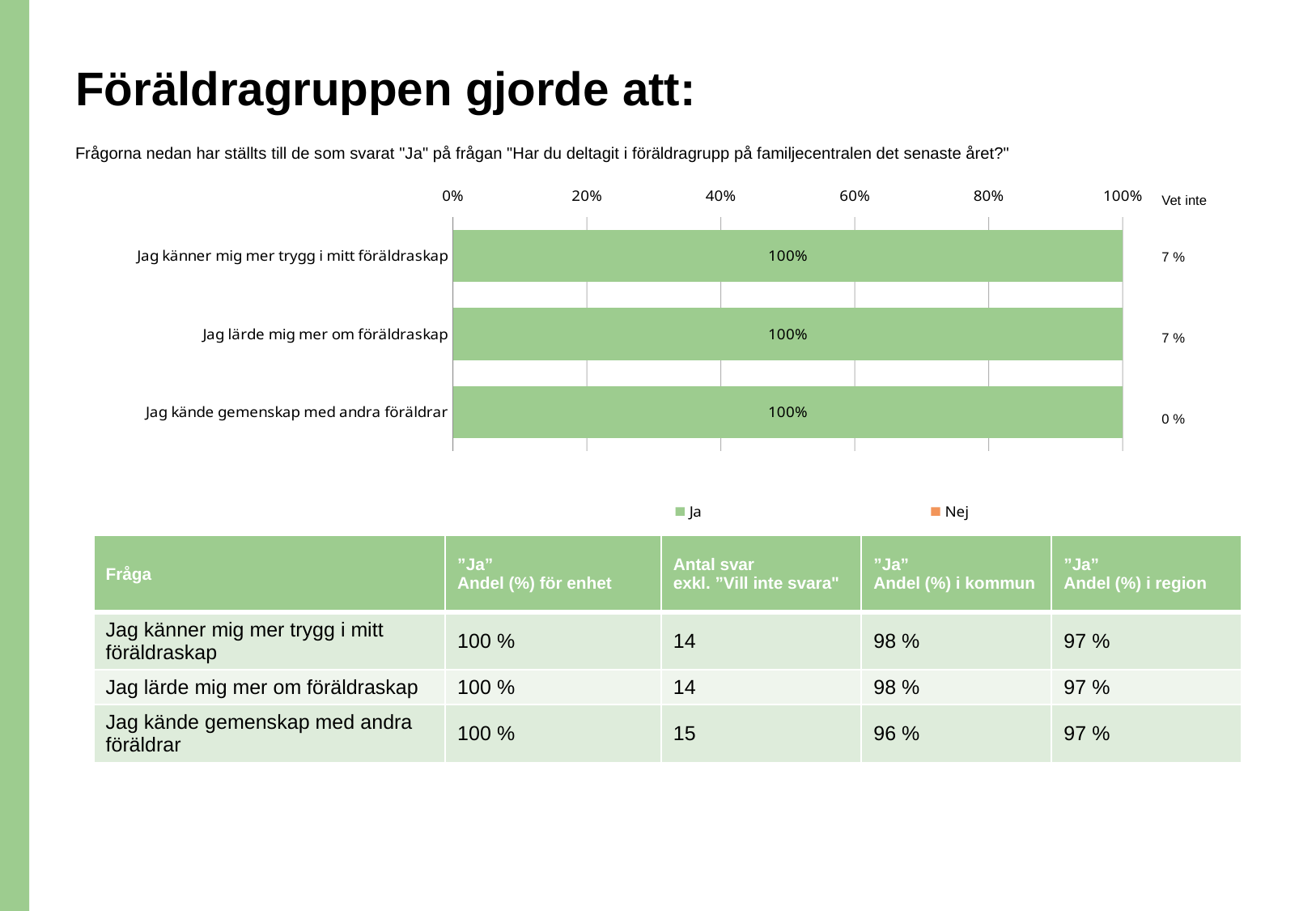
What is the "Ja" value for "Jag lärde mig mer om föräldraskap" in the bar chart? 100% What is the "Vet inte" value shown next to the bar for "Jag kände gemenskap med andra föräldrar"? 0 % What are the two series named in the chart legend? Ja and Nej How many series does the chart legend list? 2 What kind of chart is shown on the slide? bar chart How many categories (statements) are plotted in the bar chart? 3 What is the "Ja" value for "Jag känner mig mer trygg i mitt föräldraskap" in the bar chart? 100% What is the "Vet inte" value shown next to the bar for "Jag känner mig mer trygg i mitt föräldraskap"? 7 % What colour are the "Ja" bars in the chart? green Is the "Ja" value for "Jag lärde mig mer om föräldraskap" greater or less than 80%? greater What is the "Ja" value for "Jag kände gemenskap med andra föräldrar" in the bar chart? 100% What is the difference between the "Ja" values for "Jag lärde mig mer om föräldraskap" and "Jag kände gemenskap med andra föräldrar"? 0%